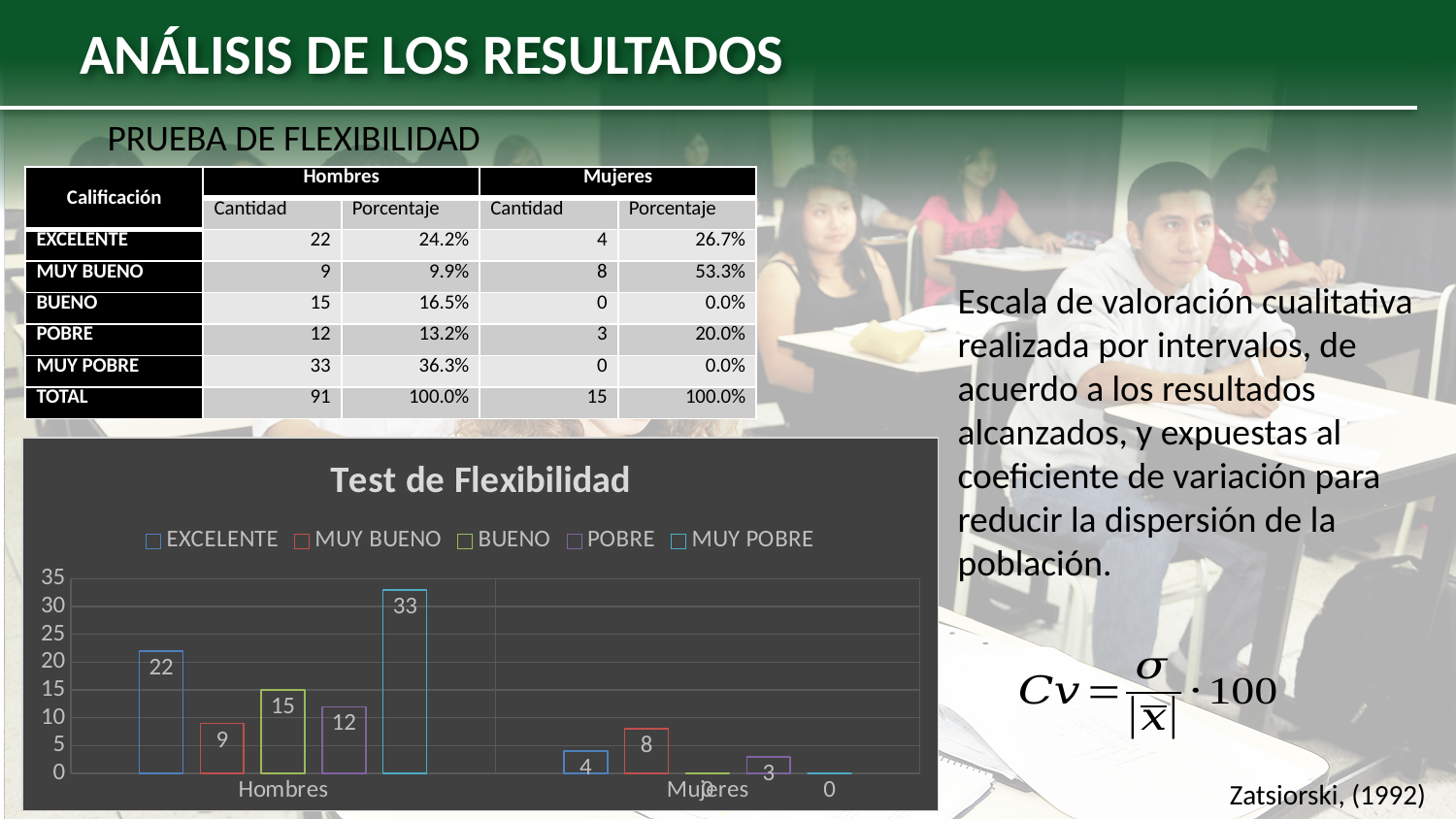
In the Test de Flexibilidad chart, what is the value for MUY POBRE in the Hombres category? 33 In the Test de Flexibilidad chart, what is the value for MUY BUENO in the Mujeres category? 8 In the Test de Flexibilidad chart, which is larger for Hombres: BUENO or POBRE? BUENO In the Test de Flexibilidad chart, which series has the highest value in the Hombres category? MUY POBRE In the Test de Flexibilidad chart, is the value for MUY POBRE in the Hombres category greater or less than 30? greater How many series does the legend of the Test de Flexibilidad chart list? 5 What kind of chart is the Test de Flexibilidad chart? bar chart In the Test de Flexibilidad chart, what is the value for POBRE in the Mujeres category? 3 What is the title of the chart on the slide? Test de Flexibilidad In the Test de Flexibilidad chart, what is the difference between the EXCELENTE value for Hombres and the EXCELENTE value for Mujeres? 18 In the Test de Flexibilidad chart, which series has the lowest value in the Hombres category? MUY BUENO How many categories are shown on the x axis of the Test de Flexibilidad chart? 2